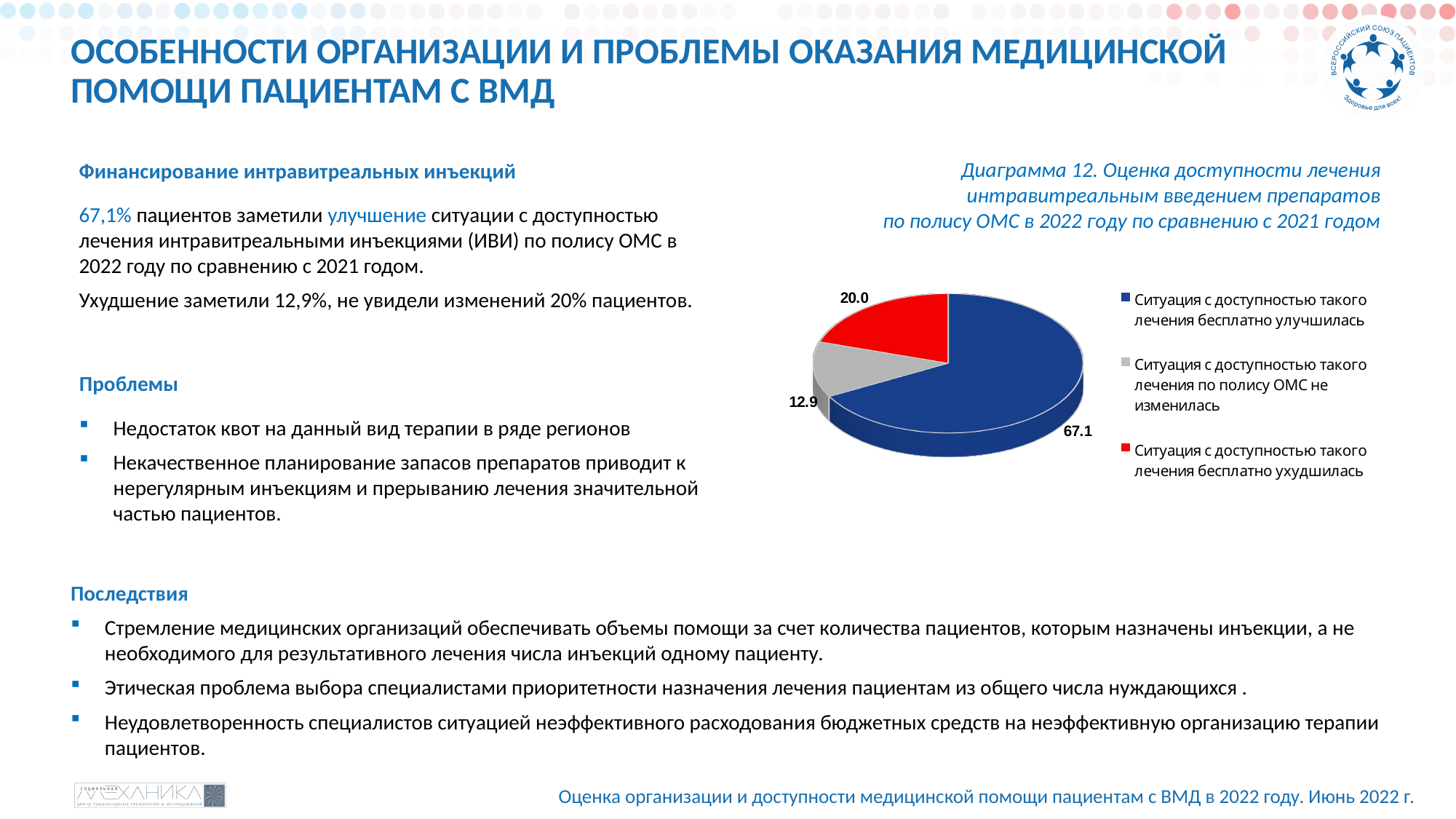
Which slice of the pie chart is the largest? Ситуация с доступностью такого лечения бесплатно улучшилась How many entries does the legend of the pie chart list? 3 Which is larger: the slice for "бесплатно ухудшилась" or the slice for "не изменилась"? бесплатно ухудшилась What kind of chart is shown on the slide? pie chart How many slices does the pie chart have? 3 What value is shown for the slice "Ситуация с доступностью такого лечения бесплатно улучшилась"? 67.1 What value is shown for the slice "Ситуация с доступностью такого лечения бесплатно ухудшилась"? 20.0 Which slice of the pie chart is the smallest? Ситуация с доступностью такого лечения по полису ОМС не изменилась What is the difference between the value for "бесплатно ухудшилась" and the value for "не изменилась"? 7.1 What is the difference between the value for "бесплатно улучшилась" and the value for "бесплатно ухудшилась"? 47.1 What value is shown for the slice "Ситуация с доступностью такого лечения по полису ОМС не изменилась"? 12.9 What colour is the slice for "Ситуация с доступностью такого лечения бесплатно ухудшилась"? red